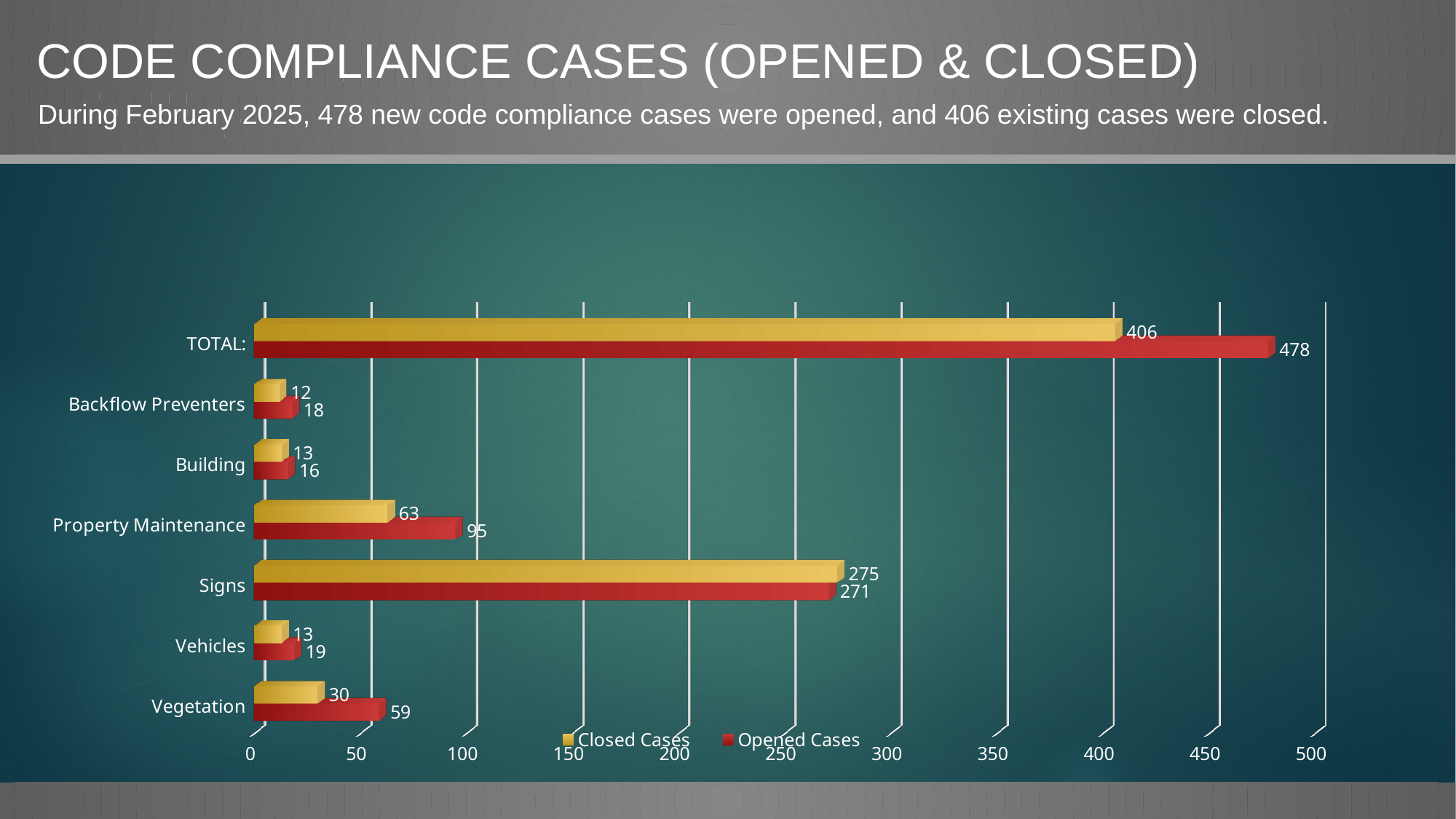
What is the difference between Opened Cases and Closed Cases for Property Maintenance? 32 Excluding the TOTAL row, which category has the lowest number of Closed Cases? Backflow Preventers Is the Opened Cases value for TOTAL greater or less than 450? greater How many Opened Cases are shown for Signs? 271 What is the Opened Cases value for Vegetation? 59 How many Closed Cases are shown for Property Maintenance? 63 Which colour represents Closed Cases in the chart? Yellow Which is larger for Signs: Closed Cases or Opened Cases? Closed Cases Excluding the TOTAL row, which category has the highest number of Opened Cases? Signs How many categories are shown on the vertical axis, including TOTAL? 7 What kind of chart is shown on the slide? Bar chart How many series does the legend list? 2